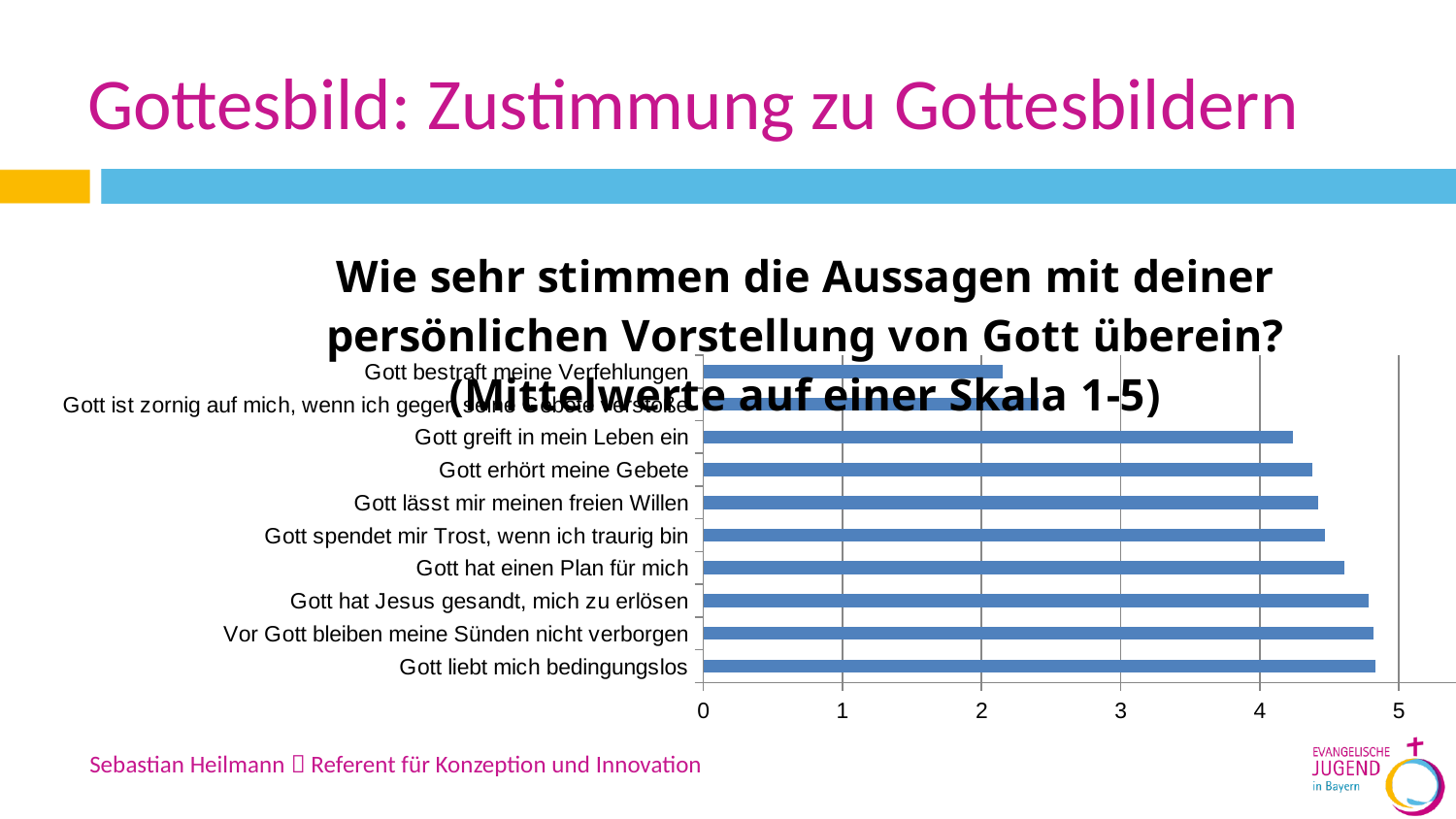
Which has the larger value: "Gott bestraft meine Verfehlungen" or "Gott hat einen Plan für mich"? Gott hat einen Plan für mich Is the value for "Gott greift in mein Leben ein" greater or less than 4? greater According to the chart title, on what scale are the mean values (Mittelwerte) given? Skala 1-5 Which statement has the lowest value in the chart? Gott bestraft meine Verfehlungen Which has the larger value: "Gott hat Jesus gesandt, mich zu erlösen" or "Gott greift in mein Leben ein"? Gott hat Jesus gesandt, mich zu erlösen Is the value for "Gott erhört meine Gebete" greater or less than 4? greater How many statements (categories) are plotted in the chart? 10 Is the value for "Gott bestraft meine Verfehlungen" greater or less than 3? less What is the maximum value shown on the chart's horizontal axis? 5 What kind of chart is shown on the slide? bar chart